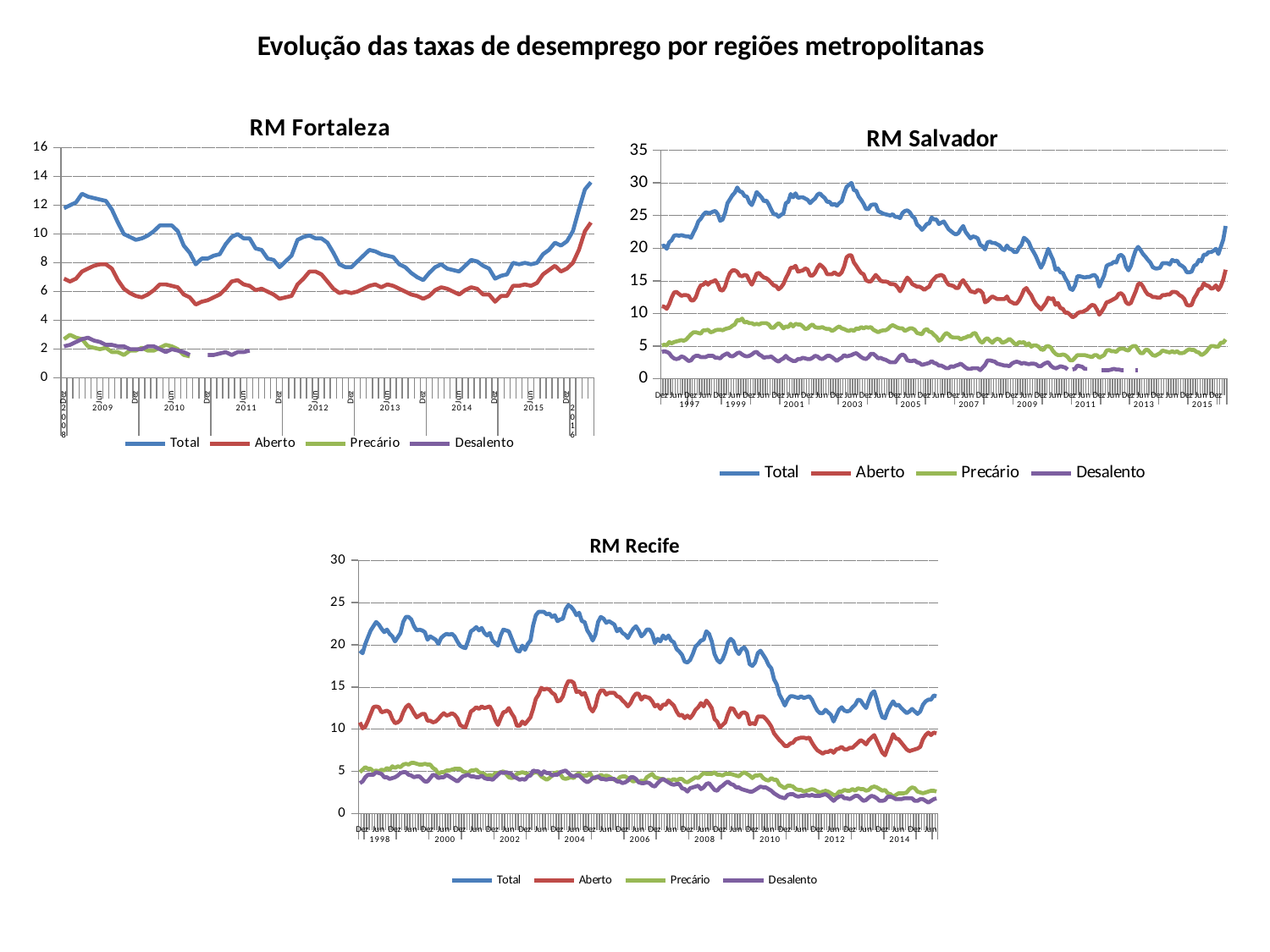
In the RM Fortaleza chart, is the value of the Total series at the end of the period (2016) greater or less than 12? greater What type of chart is the RM Fortaleza chart? line chart In the RM Recife chart, which series has the highest values? Total What are the series names listed in the legend of the RM Recife chart? Total, Aberto, Precário, Desalento How many charts are shown on the slide? 3 In the RM Recife chart, does the Total series overall rise or fall from 1998 to 2014? fall In the RM Fortaleza chart, which series is higher throughout the period, Total or Aberto? Total In the RM Salvador chart, does the Total series rise or fall between 2003 and 2011? fall How many series does the legend of the RM Salvador chart list? 4 In the RM Recife chart, is the value of the Total series in 2012 greater or less than 15? less In the RM Salvador chart, is the peak value of the Total series around 2003 greater or less than 25? greater